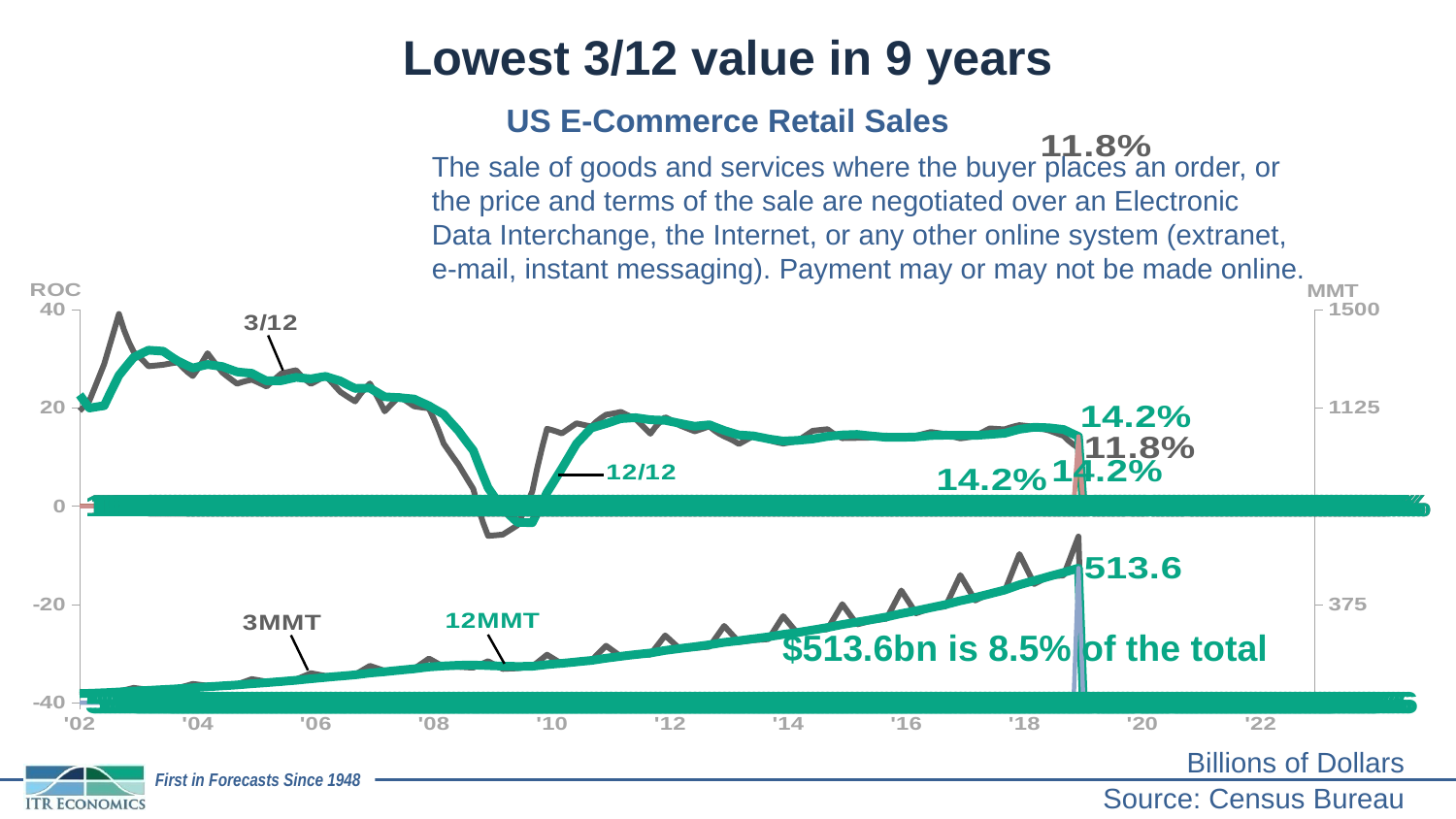
How many data series are labeled on the chart? 4 What kind of chart is shown on the slide? line chart What is the latest 12/12 rate-of-change value shown on the chart? 14.2% Is the 3/12 value at its low point around '09 greater or less than 0? less What is the title of the chart? US E-Commerce Retail Sales Is the 3/12 value at its peak around '03 greater or less than 20? greater What is the latest 3/12 rate-of-change value shown on the chart? 11.8% What is the latest value shown for the 12MMT series? 513.6 Does the 12MMT series rise or fall from '02 to its latest point? rise Which is larger, the latest 12/12 value or the latest 3/12 value? 12/12 What is the difference between the latest 12/12 value (14.2%) and the latest 3/12 value (11.8%)? 2.4% According to the annotation, what share of the total does $513.6bn represent? 8.5%